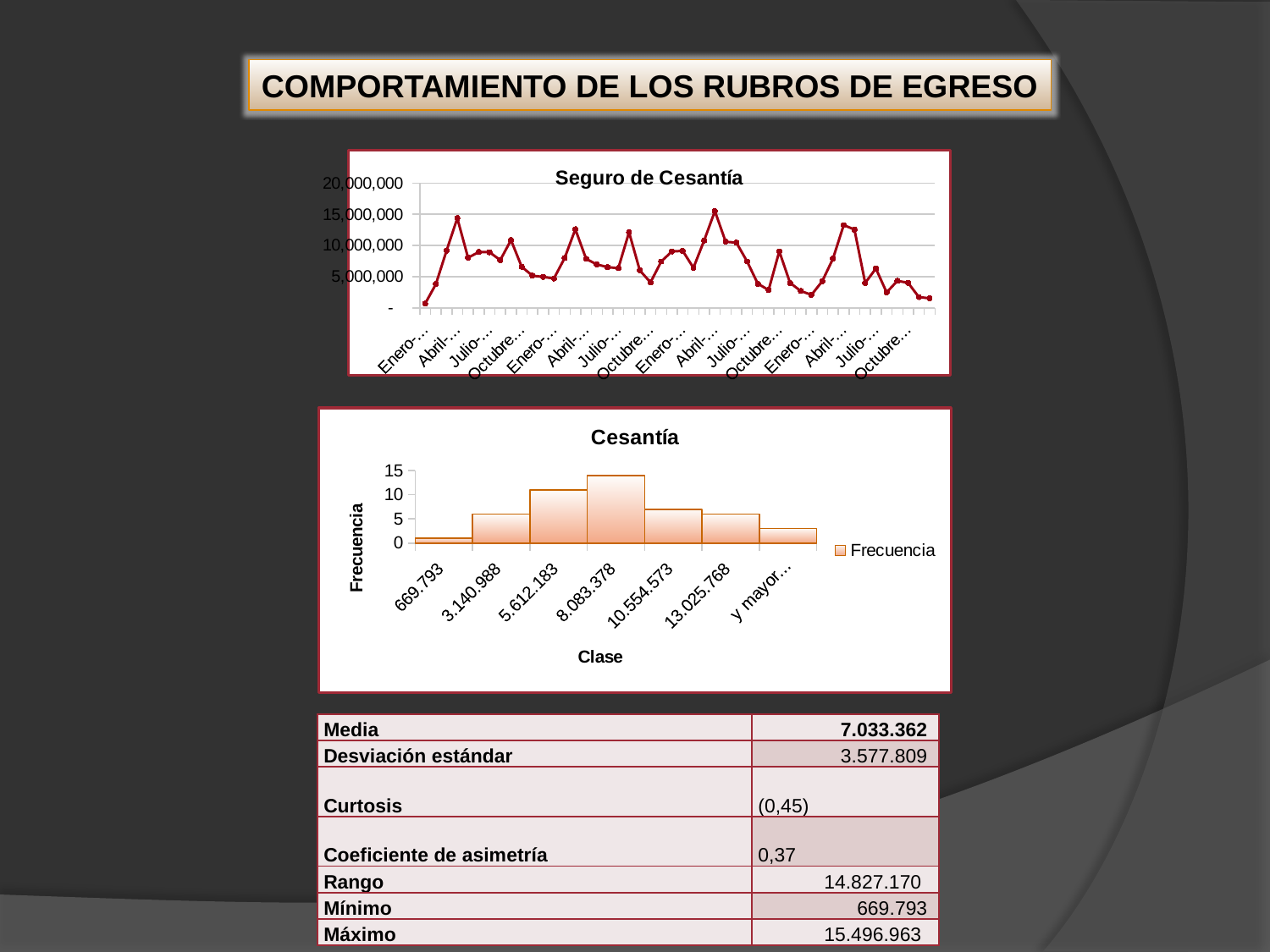
What kind of chart is the 'Seguro de Cesantía' chart? line chart In the 'Seguro de Cesantía' chart, is the highest point greater or less than 10,000,000? greater What kind of chart is the 'Cesantía' chart? bar chart How many series does the legend of the 'Cesantía' chart list? 1 In the 'Cesantía' chart, is the frequency for class 8.083.378 greater or less than 10? greater In the 'Cesantía' chart, which class has the highest frequency? 8.083.378 In the 'Cesantía' chart, which class has the larger frequency, 5.612.183 or 10.554.573? 5.612.183 How many classes are shown on the x axis of the 'Cesantía' chart? 7 In the 'Seguro de Cesantía' chart, is the lowest point greater or less than 5,000,000? less In the 'Cesantía' chart, which class has the lowest frequency? 669.793 What is the x-axis title of the 'Cesantía' chart? Clase